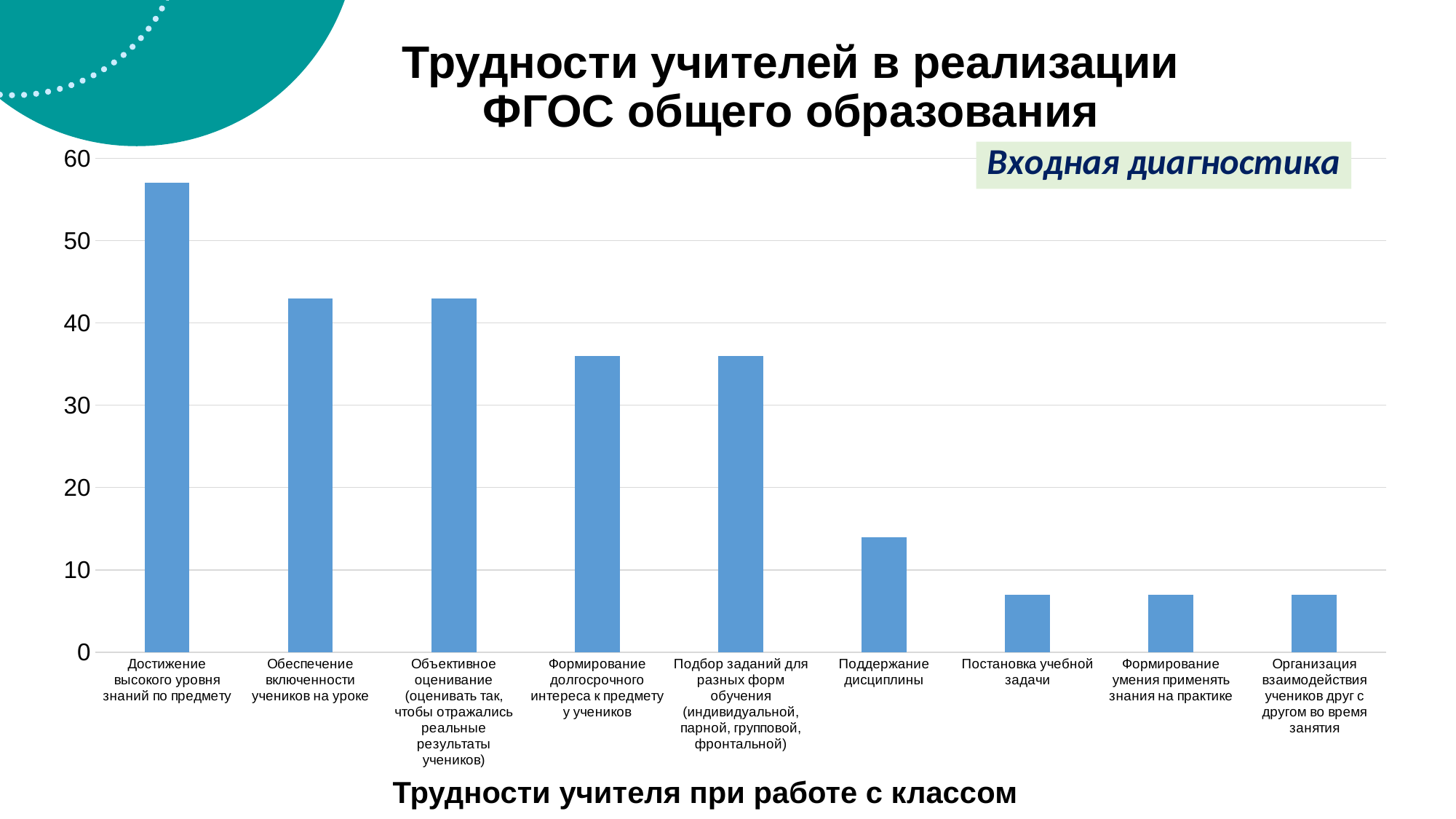
Do the values generally rise or fall from left to right along the x axis? fall Is the value for "Достижение высокого уровня знаний по предмету" greater or less than 50? greater Is the value for "Поддержание дисциплины" greater or less than 20? less Which category has the highest value on the chart? Достижение высокого уровня знаний по предмету What kind of chart is shown on the slide? bar chart How many categories are plotted on the chart? 9 Is the value for "Формирование долгосрочного интереса к предмету у учеников" greater or less than 30? greater Which is larger: the value for "Достижение высокого уровня знаний по предмету" or for "Обеспечение включенности учеников на уроке"? Достижение высокого уровня знаний по предмету What is the title of the chart's horizontal axis? Трудности учителя при работе с классом Which is larger: the value for "Поддержание дисциплины" or for "Организация взаимодействия учеников друг с другом во время занятия"? Поддержание дисциплины